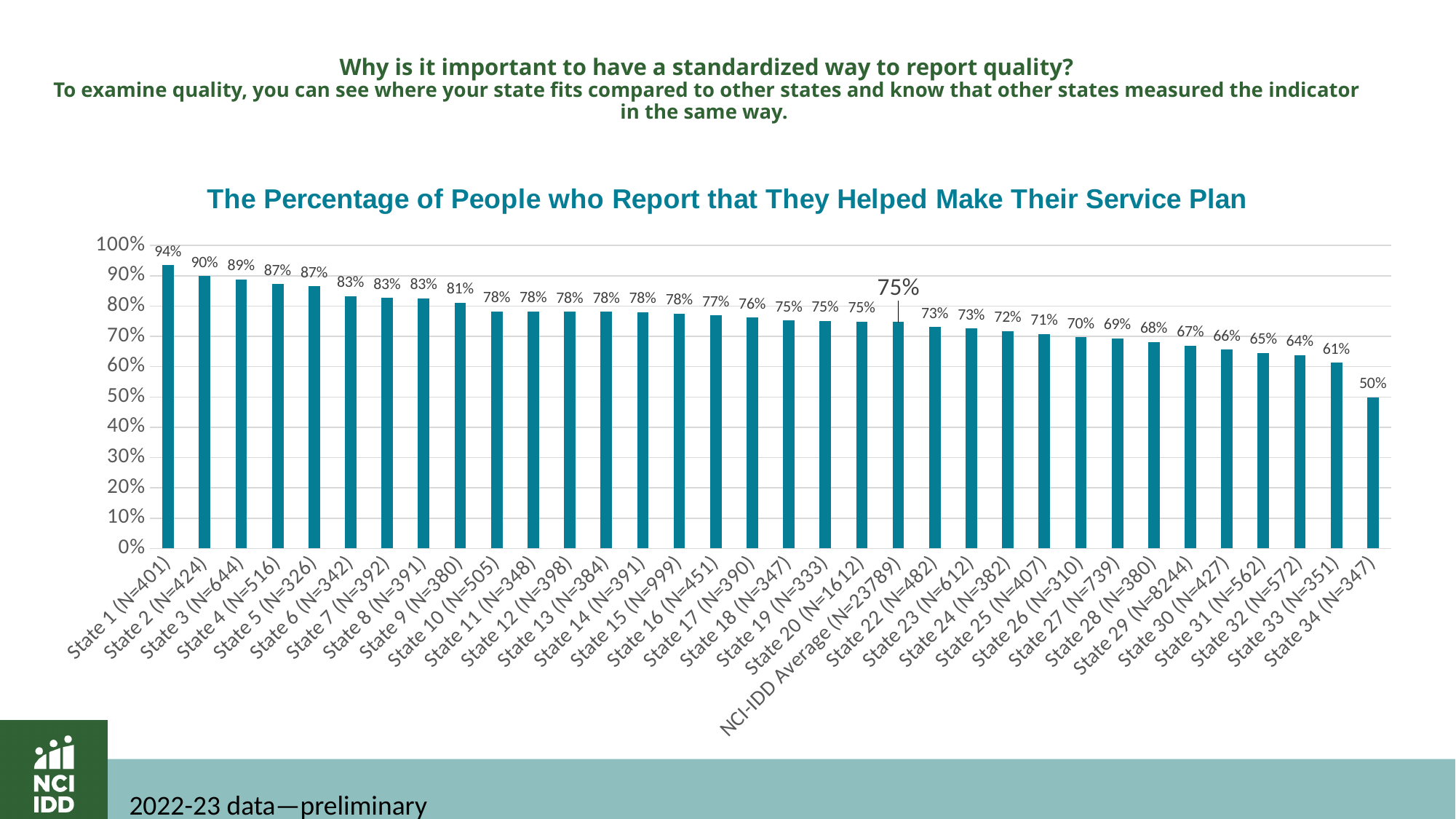
Which category has the highest value? State 1 (N=401) What is the difference between the values for State 1 (N=401) and State 34 (N=347)? 44% Which category has the lowest value? State 34 (N=347) What is the difference between the values for State 2 (N=424) and the NCI-IDD Average (N=23789)? 15% What is the value for the NCI-IDD Average (N=23789)? 75% Which is larger, the value for State 9 (N=380) or the value for State 27 (N=739)? State 9 (N=380) What is the value for State 29 (N=8244)? 67% What is the value for State 34 (N=347)? 50% How many bars are plotted in the chart? 34 Do the values rise or fall moving from left to right along the x axis? fall What is the value for State 1 (N=401)? 94% What type of chart is shown on the slide? bar chart